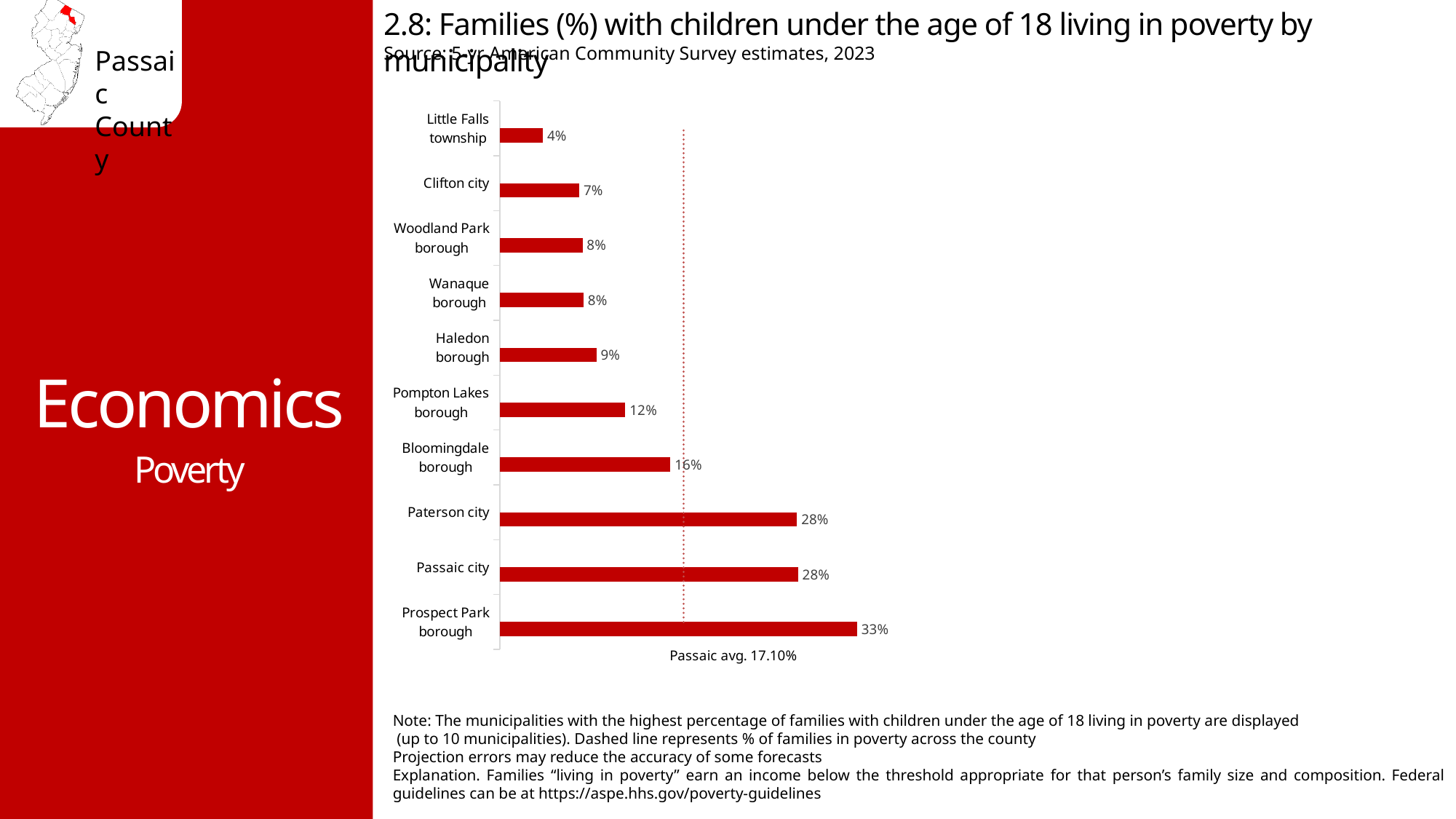
What is the difference between the values for Pompton Lakes borough and Clifton city? 5% What is the value shown for Little Falls township? 4% What percentage of families with children under 18 are living in poverty in Prospect Park borough? 33% Which municipality has the lowest percentage on the chart? Little Falls township What is the difference between the values for Prospect Park borough and Paterson city? 5% What kind of chart is shown on the slide? Bar chart What is the value shown for Passaic city? 28% Which has a higher value, Bloomingdale borough or Haledon borough? Bloomingdale borough Which municipality has the highest percentage of families with children under 18 living in poverty? Prospect Park borough What is the Passaic County average shown by the dashed line? 17.10% How many municipalities are shown on the chart? 10 What is the value shown for Bloomingdale borough? 16%